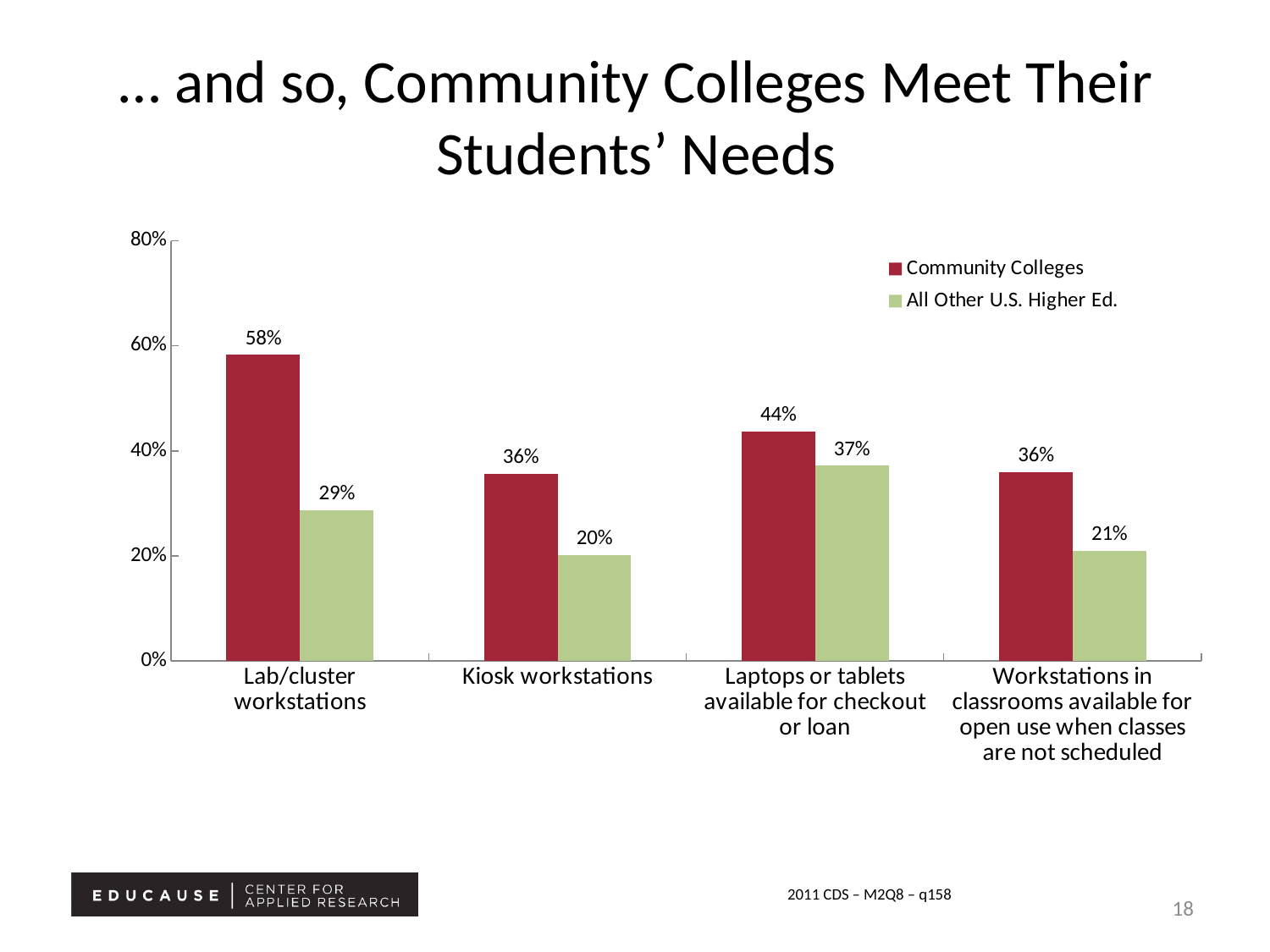
Which category has the lowest All Other U.S. Higher Ed. value? Kiosk workstations What is the value for All Other U.S. Higher Ed. for Kiosk workstations? 20% What colour are the Community Colleges bars? Red What is the difference between the Community Colleges and All Other U.S. Higher Ed. values for Lab/cluster workstations? 29% How many series does the legend list? 2 How many categories are shown on the x axis? 4 What kind of chart is shown on the slide? Bar chart What is the value for Community Colleges for Lab/cluster workstations? 58% What is the value for All Other U.S. Higher Ed. for Laptops or tablets available for checkout or loan? 37% Which category has the highest Community Colleges value? Lab/cluster workstations What is the value for Community Colleges for Workstations in classrooms available for open use when classes are not scheduled? 36% Which is larger for Laptops or tablets available for checkout or loan: Community Colleges or All Other U.S. Higher Ed.? Community Colleges